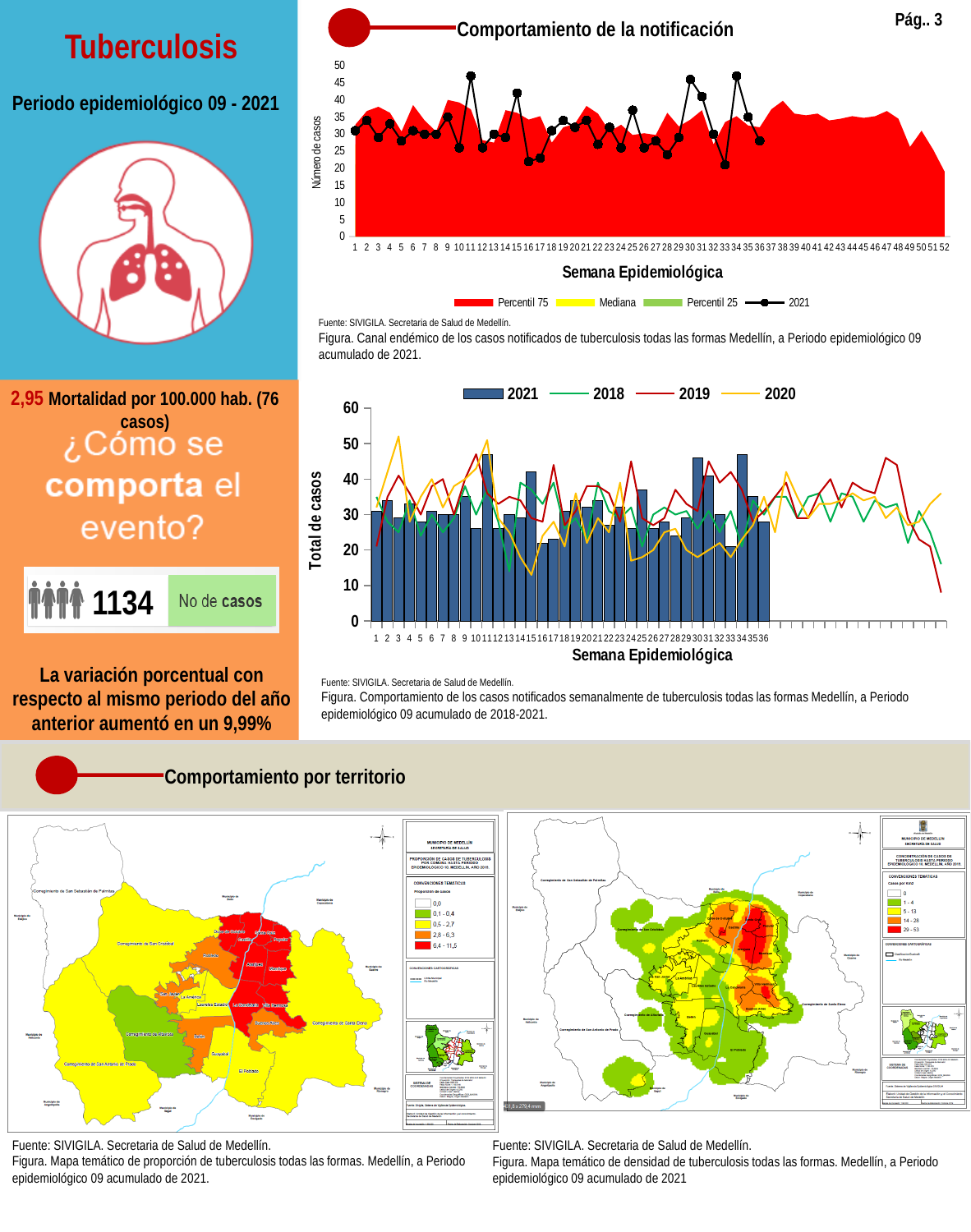
In the 'Comportamiento de la notificación' chart, what colour is the Percentil 75 band? Red In the bottom chart (2018-2021 weekly cases), how many weeks have a 2021 bar plotted? 36 In the bottom chart (2018-2021 weekly cases), is the 2021 bar for week 30 greater or less than 40? greater In the 'Comportamiento de la notificación' chart, is the 2021 value for week 33 greater or less than 25? less In the 'Comportamiento de la notificación' chart, how many series does the legend list? 4 In the bottom chart (2018-2021 weekly cases), which series is drawn as bars rather than a line? 2021 In the 'Comportamiento de la notificación' chart, what is the label of the x axis? Semana Epidemiológica In the bottom chart (2018-2021 weekly cases), is the 2021 bar for week 33 greater or less than 30? less In the bottom chart (2018-2021 weekly cases), how many series does the legend list? 4